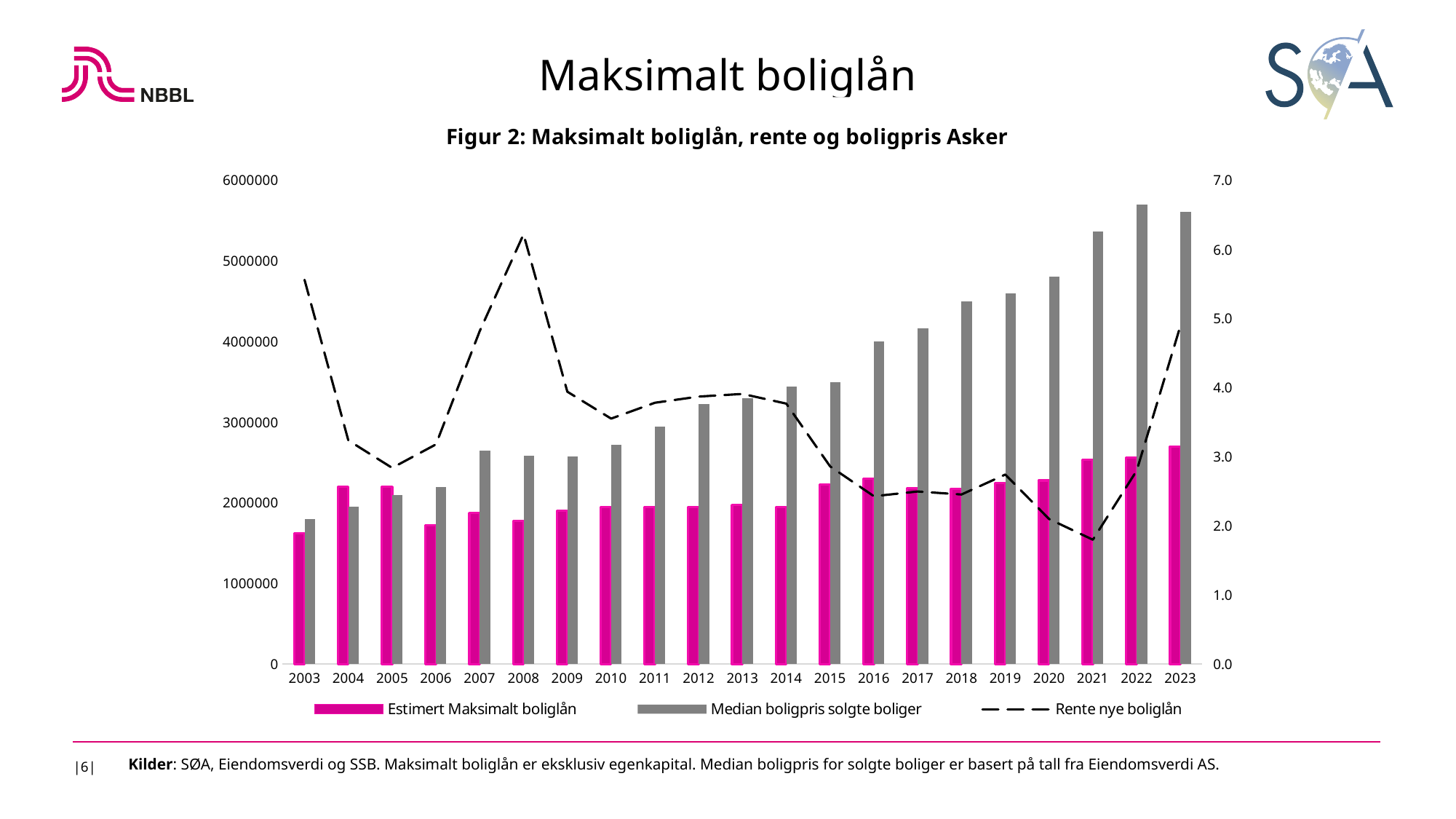
Is the Rente nye boliglån value for 2008 greater or less than 6.0? greater Does the Median boligpris solgte boliger series generally rise or fall from 2003 to 2022? Rise In which year does the Rente nye boliglån line reach its lowest point? 2021 In which year does the Rente nye boliglån line reach its highest point? 2008 How many series does the legend list? 3 What kind of chart is shown on the slide? A combined bar and line chart In which year is the Estimert Maksimalt boliglån bar the highest? 2023 Which is larger in 2004: Estimert Maksimalt boliglån or Median boligpris solgte boliger? Estimert Maksimalt boliglån How many years are shown on the x axis? 21 Is the Estimert Maksimalt boliglån value for 2006 greater or less than 2000000? less Is the Median boligpris solgte boliger value for 2023 greater or less than 5000000? greater In which year is the Median boligpris solgte boliger bar the lowest? 2003